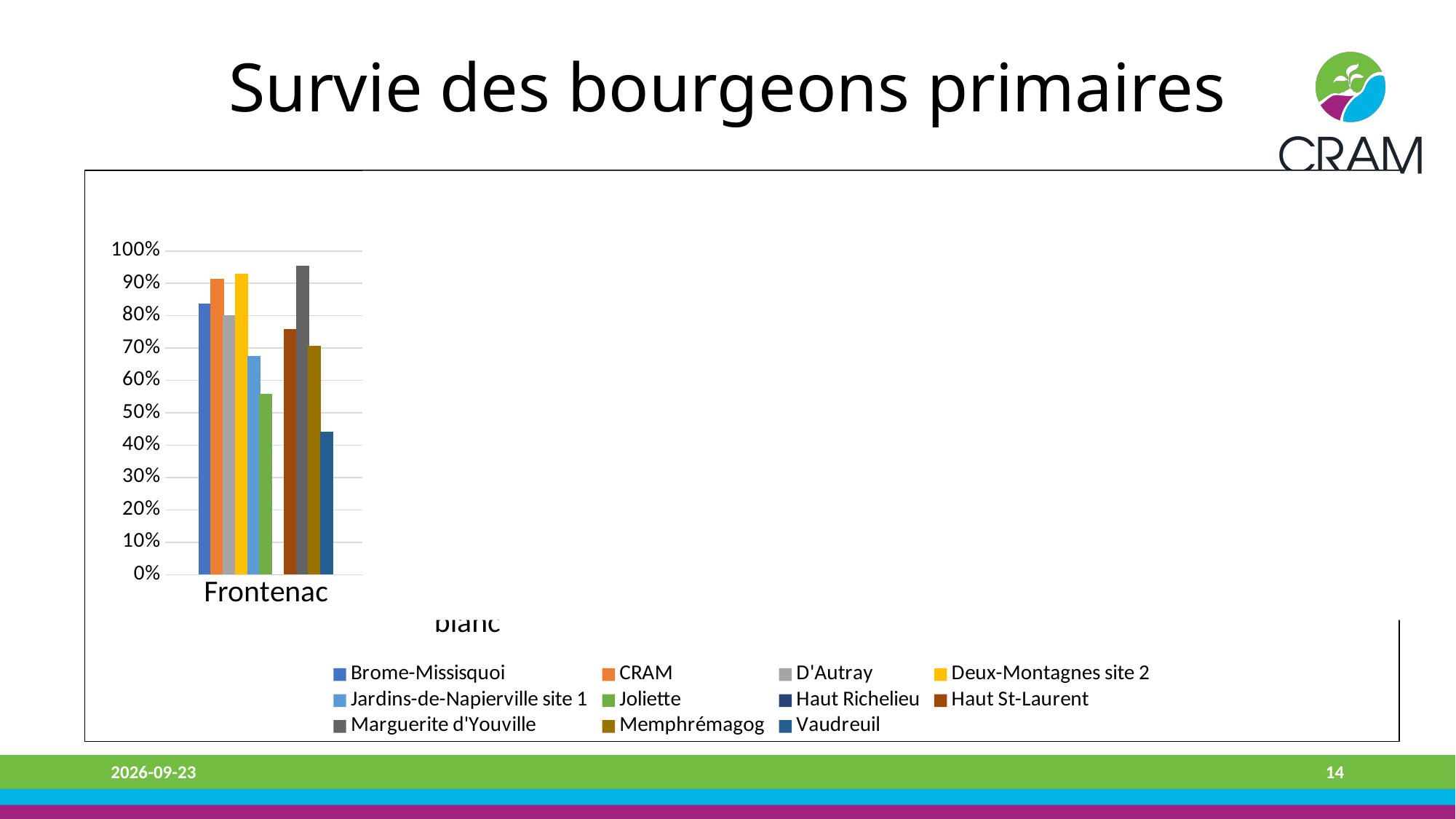
Which is larger, the value for CRAM or the value for D'Autray? CRAM Is the value for CRAM greater or less than 90%? greater How many series does the legend list? 11 Is the value for Marguerite d'Youville greater or less than 90%? greater Is the value for Vaudreuil greater or less than 50%? less Which is larger, the value for Joliette or the value for Vaudreuil? Joliette What kind of chart is shown on the slide? bar chart What is the category label shown on the x axis? Frontenac